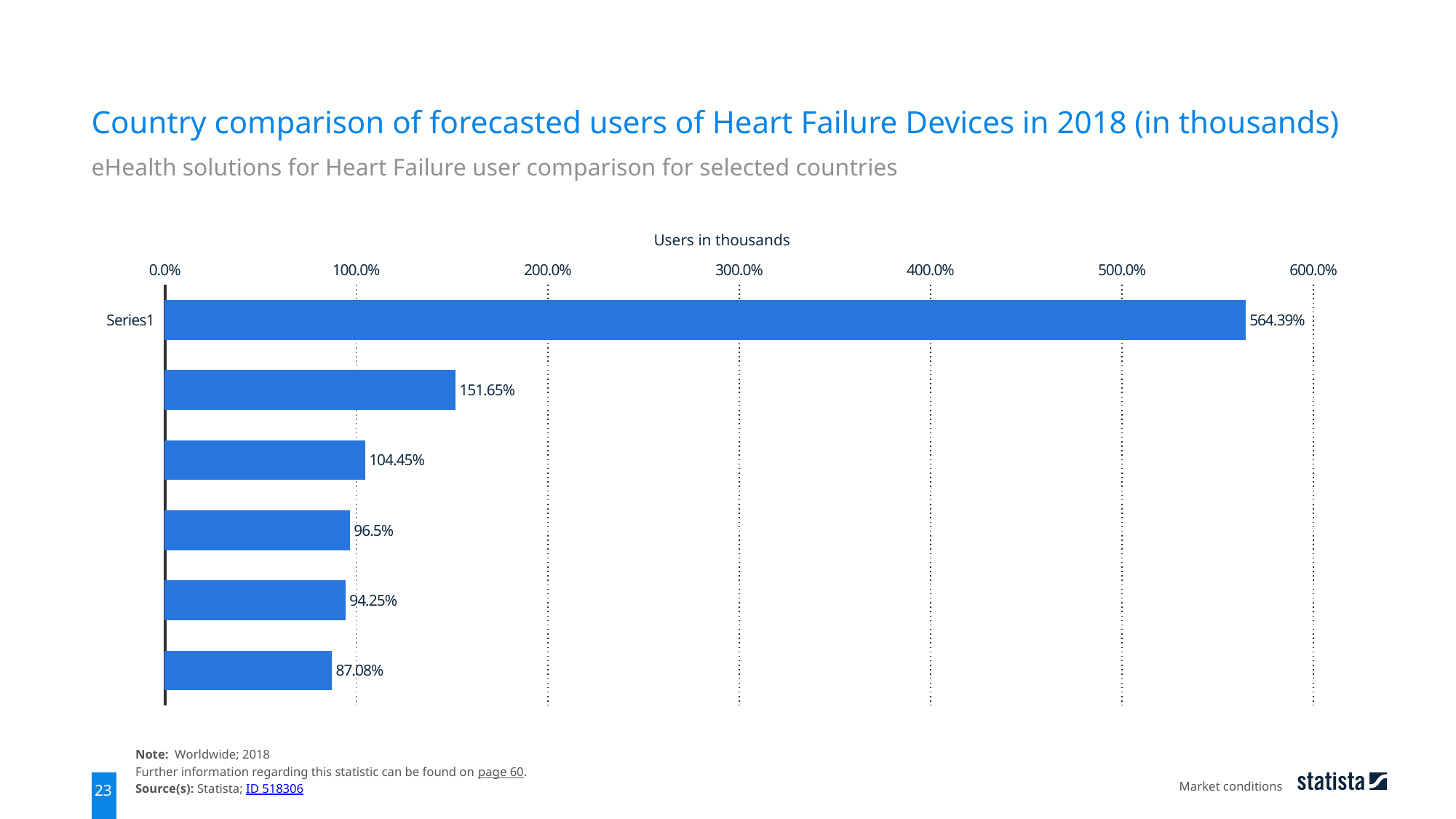
What is the value shown on the bottom bar of the chart? 87.08% What type of chart is shown on the slide? bar chart What is the value shown on the third bar from the top? 104.45% How many bars are plotted on the chart? 6 What is the axis title shown above the chart? Users in thousands What is the lowest value shown on the chart? 87.08% Which is larger, the value of the fourth bar from the top or the value of the fifth bar from the top? the fourth bar (96.5%) What is the difference between the top bar (564.39%) and the second bar (151.65%)? 412.74% What is the highest value shown on the chart? 564.39% What is the value shown on the second bar from the top? 151.65% What is the value shown for the bar labelled Series1? 564.39% Do the bar values rise or fall going from the top bar to the bottom bar? fall